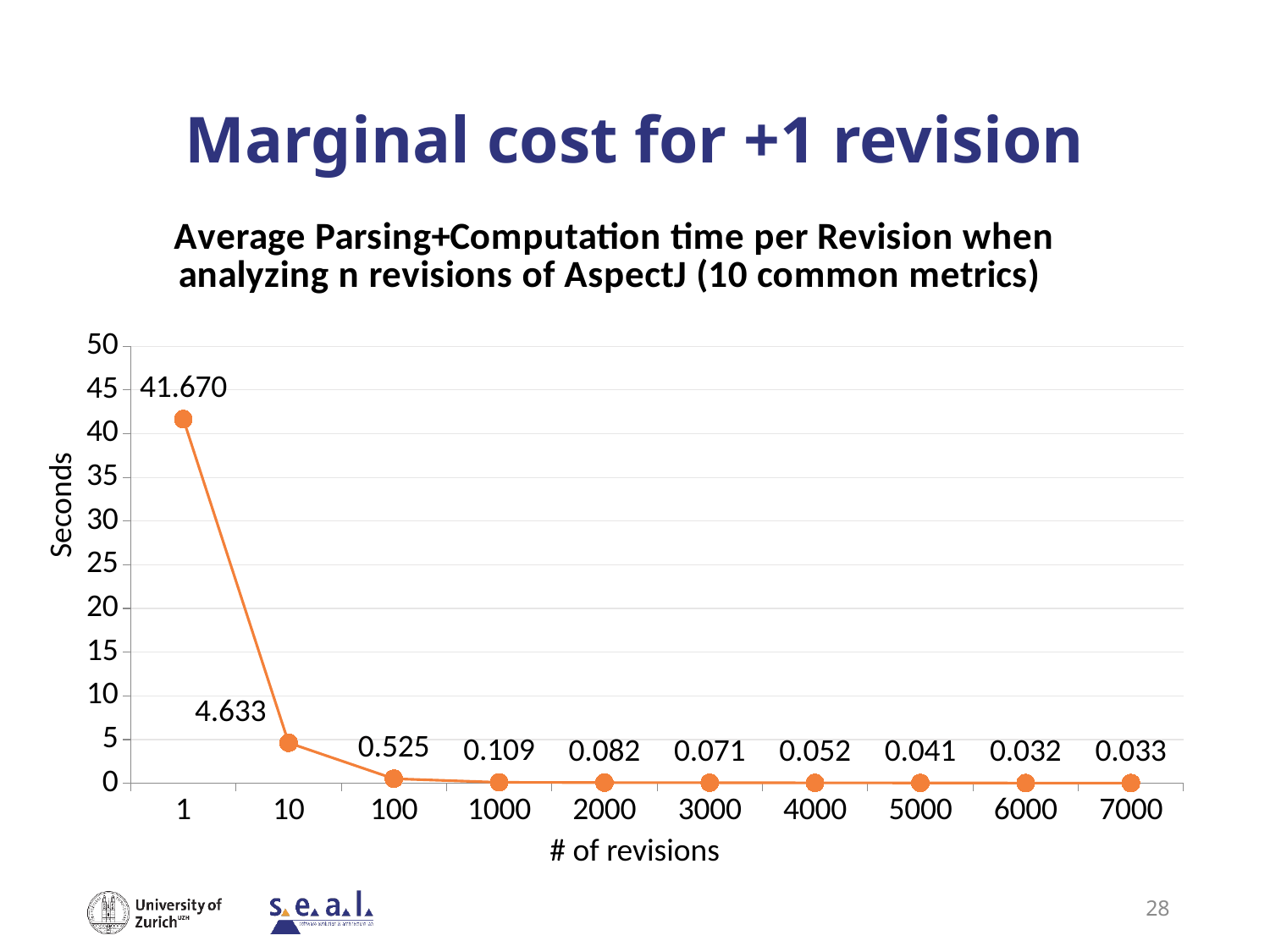
What is the value plotted for 4000 revisions? 0.052 What is the average parsing+computation time per revision when analyzing 1 revision? 41.670 What is the value plotted for 10 revisions? 4.633 What is the difference between the values for 1 revision and 10 revisions? 37.037 What kind of chart is shown on the slide? Line chart What is the difference between the values for 10 revisions and 100 revisions? 4.108 At which number of revisions is the average time per revision highest? 1 Which is larger, the value for 1000 revisions or the value for 3000 revisions? 1000 revisions How many data points are plotted on the chart? 10 What is the value plotted for 100 revisions? 0.525 Do the values rise or fall as the number of revisions increases along the x axis? Fall What is the value plotted for 7000 revisions? 0.033